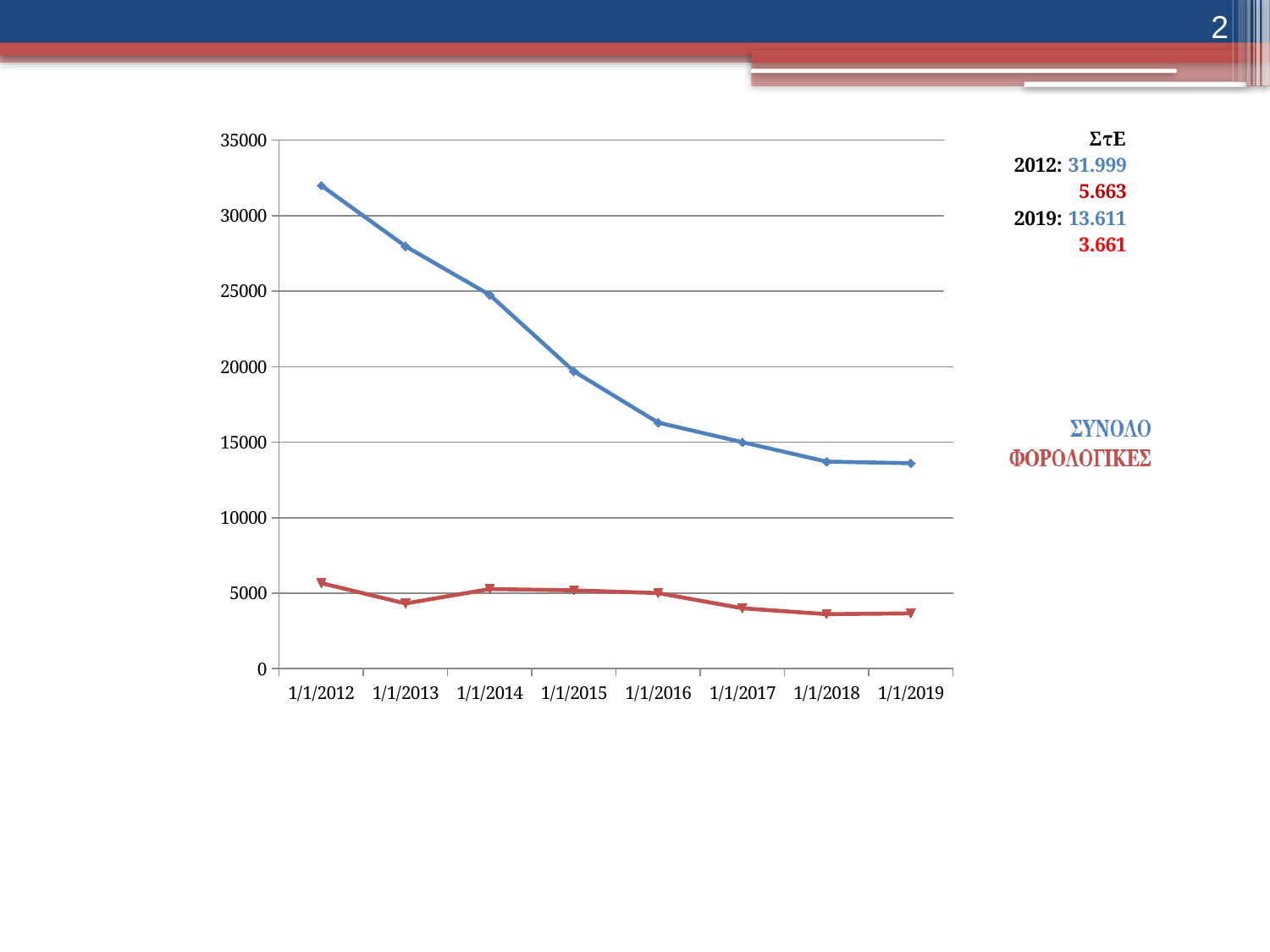
How many data series are plotted on the chart? 2 Does the ΣΥΝΟΛΟ (blue) line rise or fall from 1/1/2012 to 1/1/2019? fall By how much did the ΦΟΡΟΛΟΓΙΚΕΣ value fall from 2012 to 2019, using the figures printed on the slide? 2.002 At which date does the ΣΥΝΟΛΟ (blue) line reach its highest value? 1/1/2012 By how much did the ΣΥΝΟΛΟ value fall from 2012 to 2019, using the figures printed on the slide? 18.388 According to the text on the slide, what is the ΣΥΝΟΛΟ value for 2019? 13.611 According to the text on the slide, what is the ΣΥΝΟΛΟ value for 2012? 31.999 What kind of chart is shown on the slide? line chart According to the text on the slide, what is the ΦΟΡΟΛΟΓΙΚΕΣ value for 2019? 3.661 Is the ΦΟΡΟΛΟΓΙΚΕΣ (red) value at 1/1/2013 greater or less than 5000? less How many dates are shown along the x axis of the chart? 8